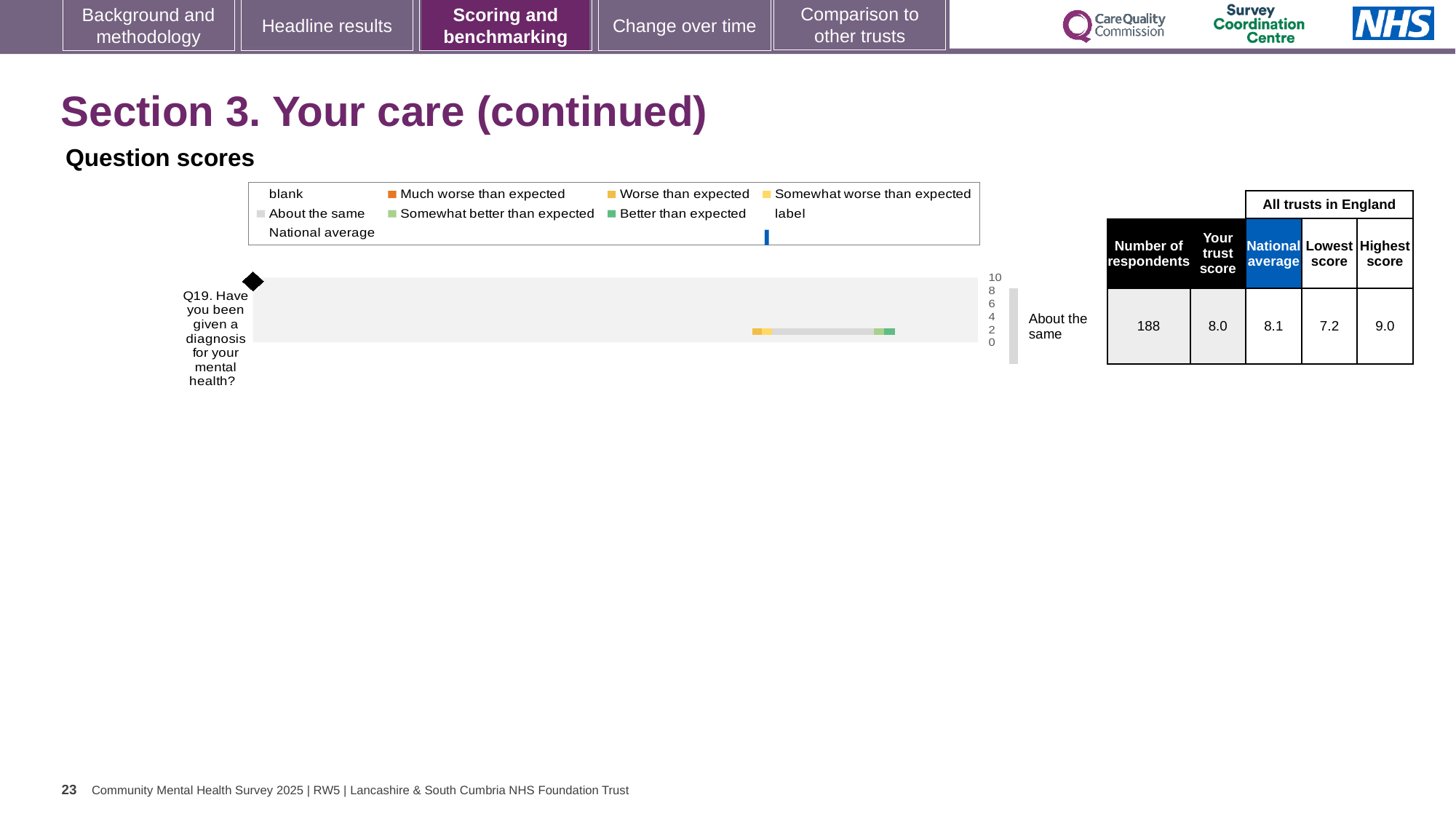
Is the trust score for Q19 higher or lower than the national average? lower What is the trust score for Q19 shown in the table next to the chart? 8.0 How many questions are plotted in the Question scores chart? 1 What is the highest score among all trusts in England for Q19? 9.0 What is the lowest score among all trusts in England for Q19? 7.2 What is the maximum value shown on the chart's score axis? 10 What is the national average for Q19 shown in the table next to the chart? 8.1 What kind of chart is used to show the Q19 question score? bar chart What is the difference between the highest and lowest scores for Q19 across all trusts in England? 1.8 Which question is shown in the Question scores chart? Q19. Have you been given a diagnosis for your mental health? How many respondents answered Q19? 188 Which benchmark category is Q19 placed in? About the same